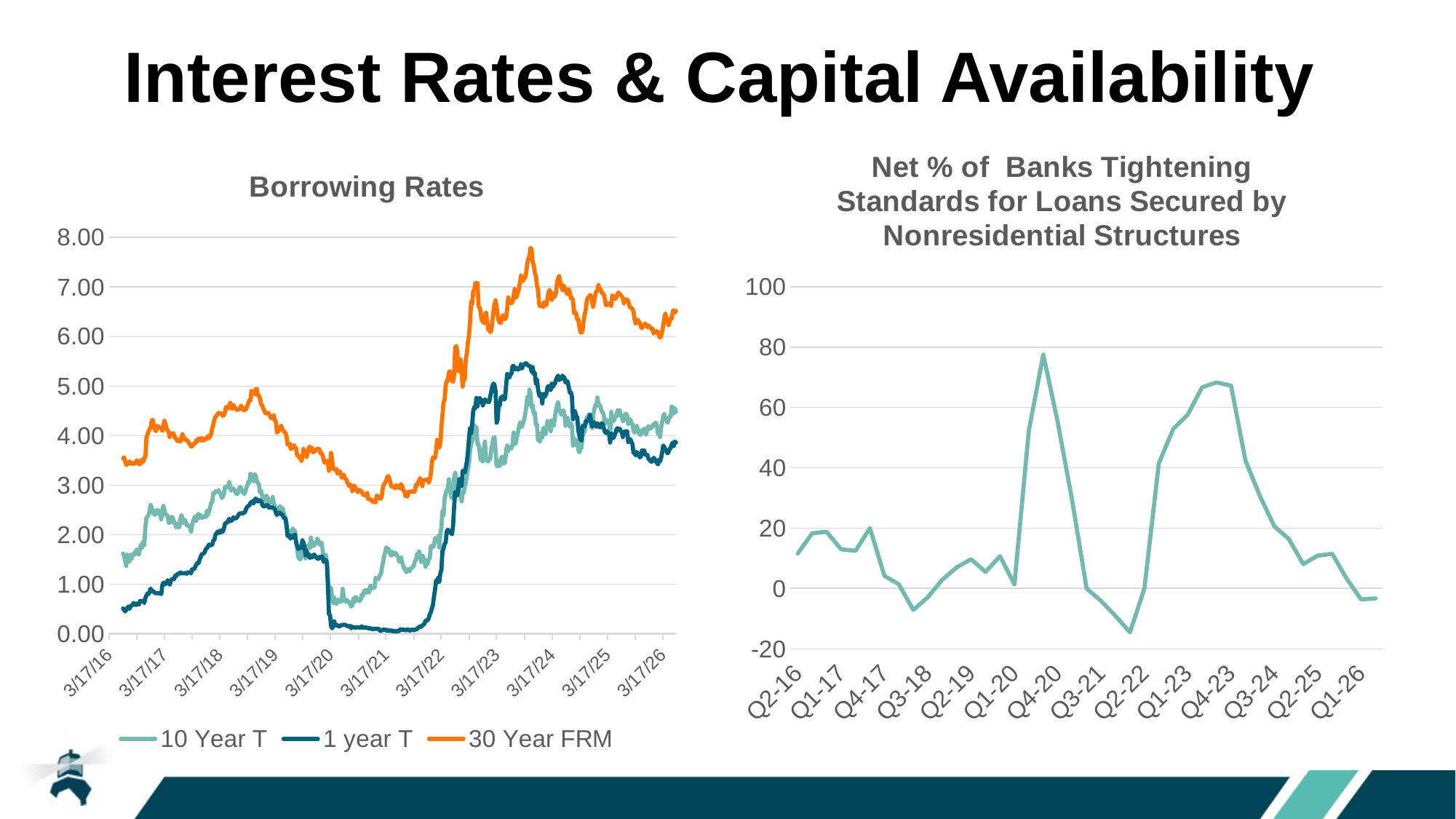
In the Borrowing Rates chart, at 3/17/21 which series is larger, 30 Year FRM or 1 year T? 30 Year FRM In the chart titled 'Net % of Banks Tightening Standards for Loans Secured by Nonresidential Structures', does the line rise or fall from Q4-23 to Q1-26? fall In the Borrowing Rates chart, is the 30 Year FRM value at 3/17/16 greater or less than 3.00? greater In the Borrowing Rates chart, does the 30 Year FRM series rise or fall between 3/17/21 and 3/17/23? rise How many series does the legend of the Borrowing Rates chart list? 3 In the Borrowing Rates chart, which series is plotted in orange? 30 Year FRM What are the three series named in the legend of the Borrowing Rates chart? 10 Year T, 1 year T, 30 Year FRM What kind of chart is the Borrowing Rates chart on the left? line chart In the Borrowing Rates chart, is the 1 year T value at 3/17/21 greater or less than 1.00? less